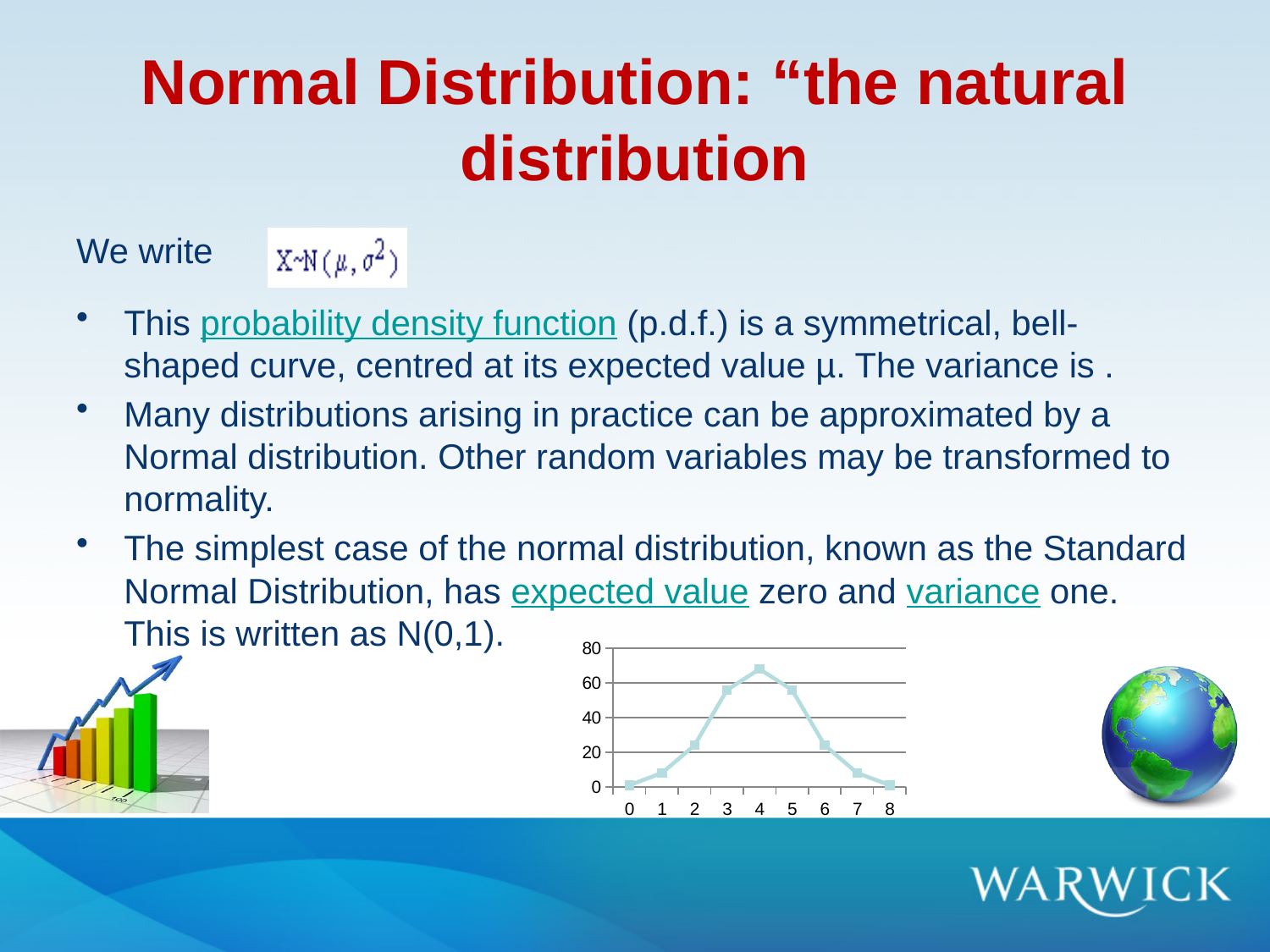
On the line chart, which has the larger value: x = 3 or x = 1? 3 Is the value at x = 2 on the line chart greater or less than 40? less What kind of chart is shown at the bottom centre of the slide? line chart Is the value at x = 4 on the line chart greater or less than 60? greater How many data points are plotted on the line chart? 9 Is the value at x = 7 on the line chart greater or less than 20? less What is the highest tick value shown on the y axis of the line chart? 80 At which x value does the line chart reach its highest point? 4 On the line chart, do the values rise or fall as x goes from 0 to 4? rise On the line chart, which has the larger value: x = 4 or x = 2? 4